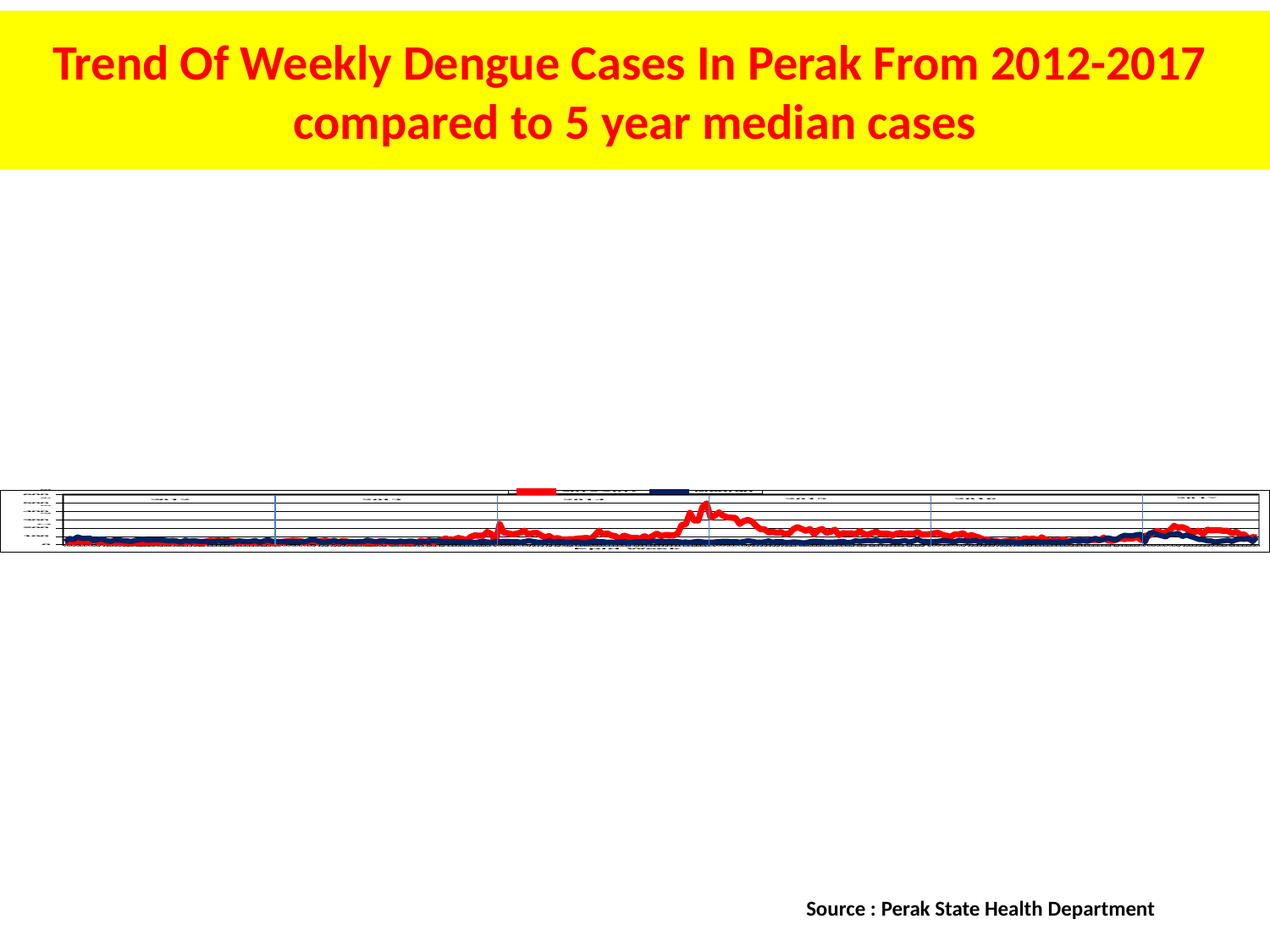
According to the slide title, which state's weekly dengue cases does the chart show? Perak Which line reaches the highest peak in the chart, the red line or the blue line? the red line What kind of chart is shown on the slide? line chart What two colours are used for the lines in the chart? red and blue How many series does the chart's legend list? 2